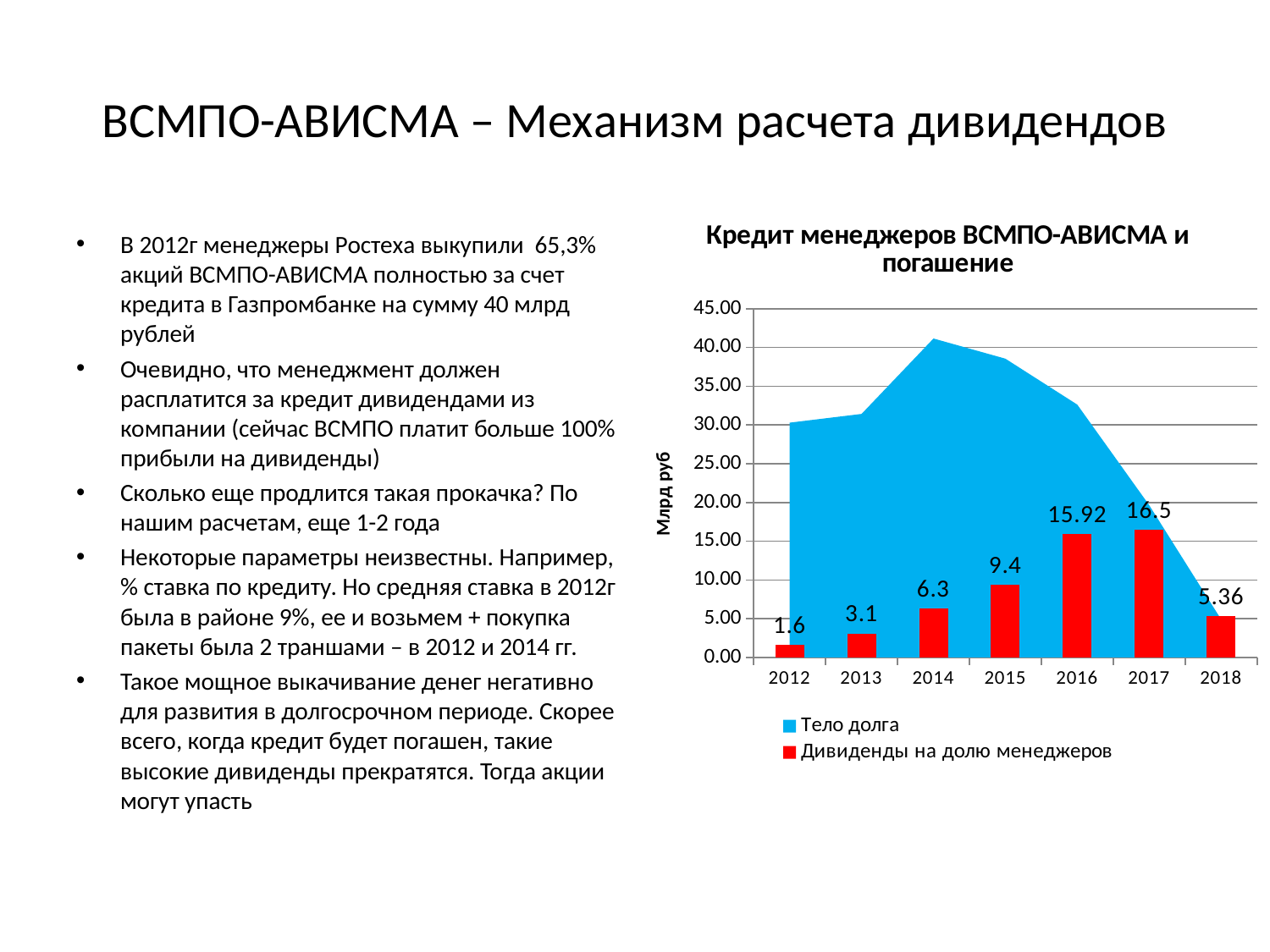
What is the value of Дивиденды на долю менеджеров for 2014? 6.3 In which year is Дивиденды на долю менеджеров the lowest? 2012 Is the value of Тело долга for 2012 greater or less than 25.00? greater In which year is Дивиденды на долю менеджеров the highest? 2017 Is the value of Тело долга for 2015 greater or less than 35.00? greater What is the title of the chart? Кредит менеджеров ВСМПО-АВИСМА и погашение What is the difference between Дивиденды на долю менеджеров in 2015 and 2014? 3.1 How many series does the chart legend list? 2 What is the value of Дивиденды на долю менеджеров for 2016? 15.92 Which year has a larger value of Дивиденды на долю менеджеров, 2013 or 2018? 2018 How many years are shown on the x axis of the chart? 7 What is the value of Дивиденды на долю менеджеров for 2018? 5.36